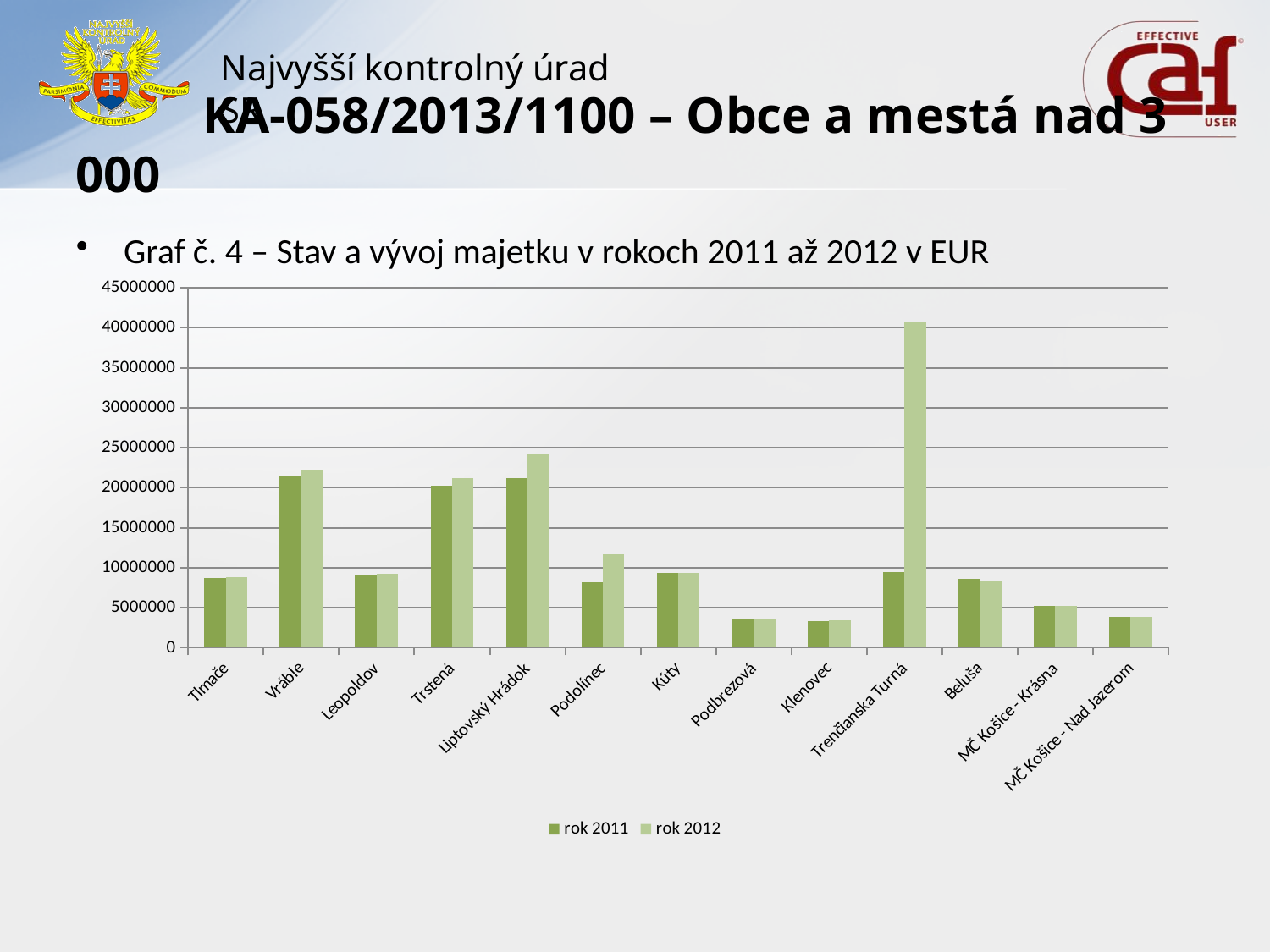
Is the rok 2011 value for Vráble greater or less than 20000000? greater How many municipalities (categories) are shown on the x axis of the chart? 13 Is the rok 2011 value for Tlmače greater or less than 10000000? less What kind of chart is shown on the slide? bar chart Which is larger for rok 2012: Liptovský Hrádok or Vráble? Liptovský Hrádok Is the rok 2012 value for Liptovský Hrádok greater or less than 25000000? less For Trenčianska Turná, which series has the larger value, rok 2011 or rok 2012? rok 2012 How many series does the chart's legend list? 2 Which municipality has the highest bar in the chart? Trenčianska Turná What are the two series named in the chart's legend? rok 2011 and rok 2012